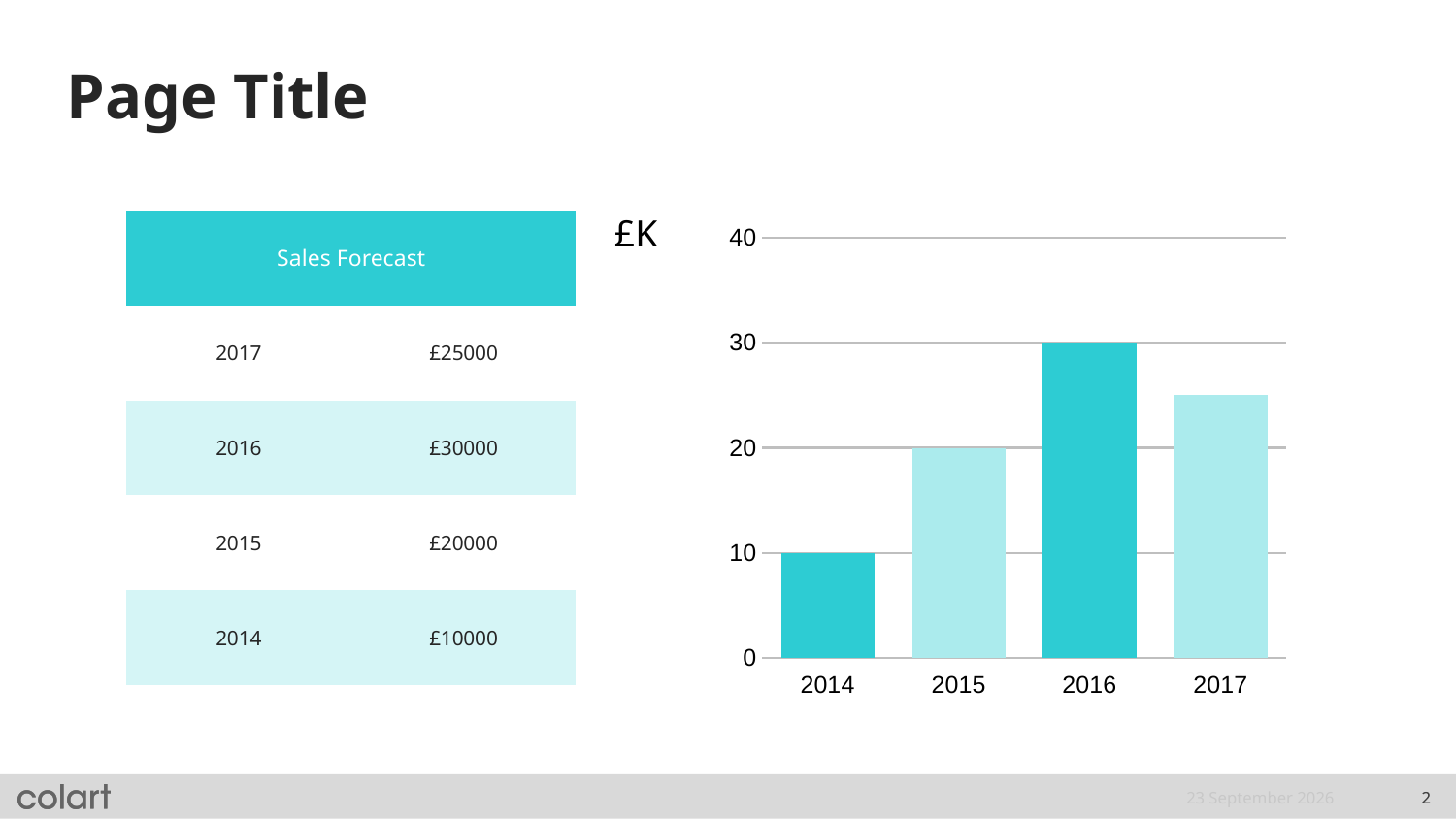
How many bars (years) are plotted in the chart? 4 What is the value for 2015 in the chart? 20 Do the values in the chart rise or fall from 2014 to 2016? rise What is the value for 2014 in the chart? 10 Which year has the highest bar in the chart? 2016 What kind of chart is shown on the slide? bar chart What is the value for 2016 in the chart? 30 What is the difference between the values for 2016 and 2014 in the chart? 20 Which year has the lowest bar in the chart? 2014 What unit label is shown next to the chart's vertical axis? £K Is the value for 2017 in the chart greater or less than 20? greater Which is larger in the chart, the value for 2015 or the value for 2017? 2017